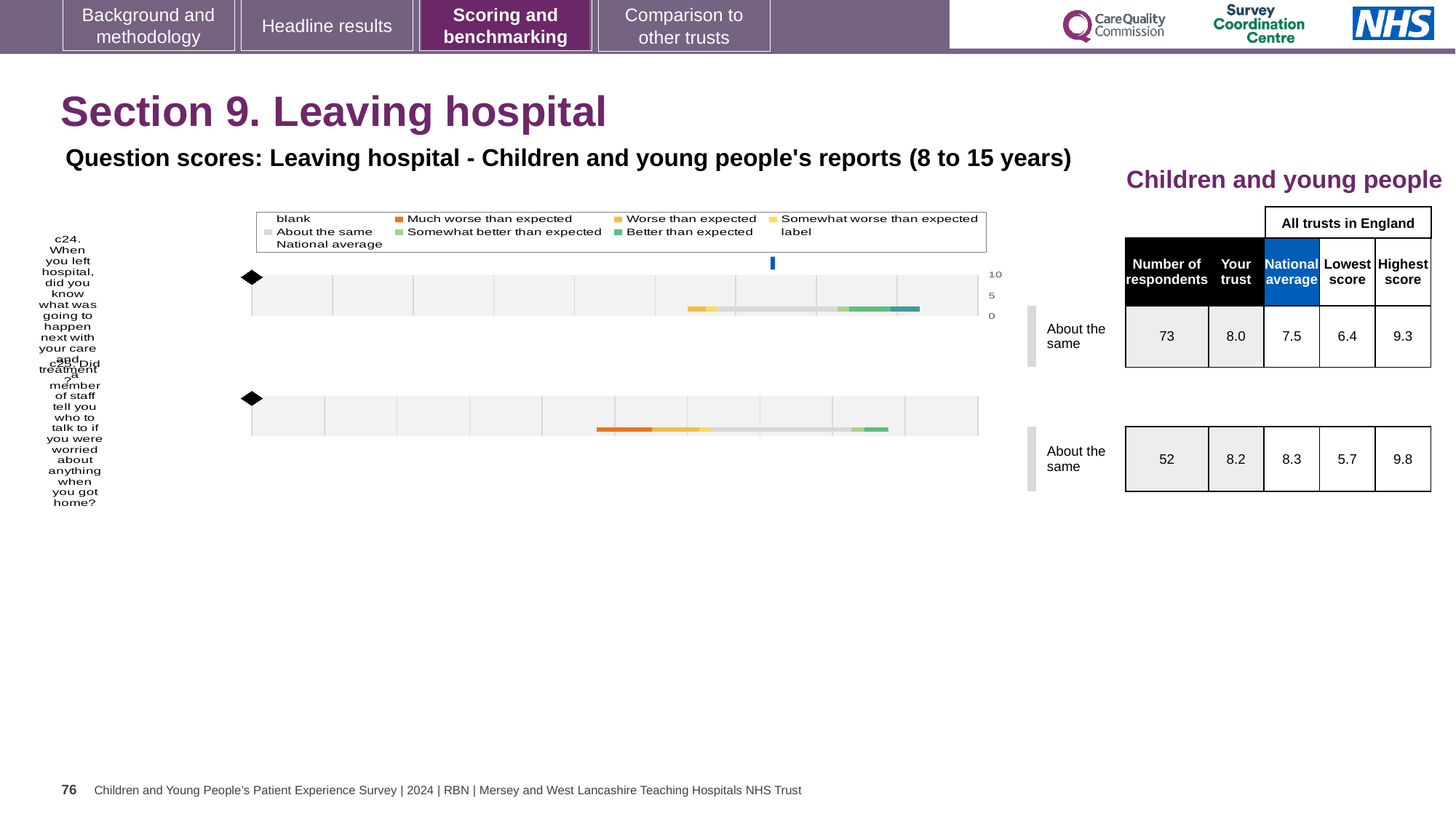
For question c24, which is higher: the 'Your trust' score or the national average? Your trust What is the difference between the highest score and the lowest score for question c24? 2.9 What is the difference between the highest score and the lowest score for question c25? 4.1 What benchmark category is shown for question c25? About the same What is the 'Your trust' score for question c25 (Did a member of staff tell you who to talk to if you were worried about anything when you got home?)? 8.2 What is the national average score for question c25? 8.3 What is the national average score for question c24? 7.5 How many respondents answered question c24? 73 How many survey questions are plotted on the slide? 2 What is the 'Your trust' score for question c24 (When you left hospital, did you know what was going to happen next with your care and treatment?)? 8.0 What kind of chart is used to show the question scores for c24 and c25? bar chart Which of the two questions has the higher 'Your trust' score? c25